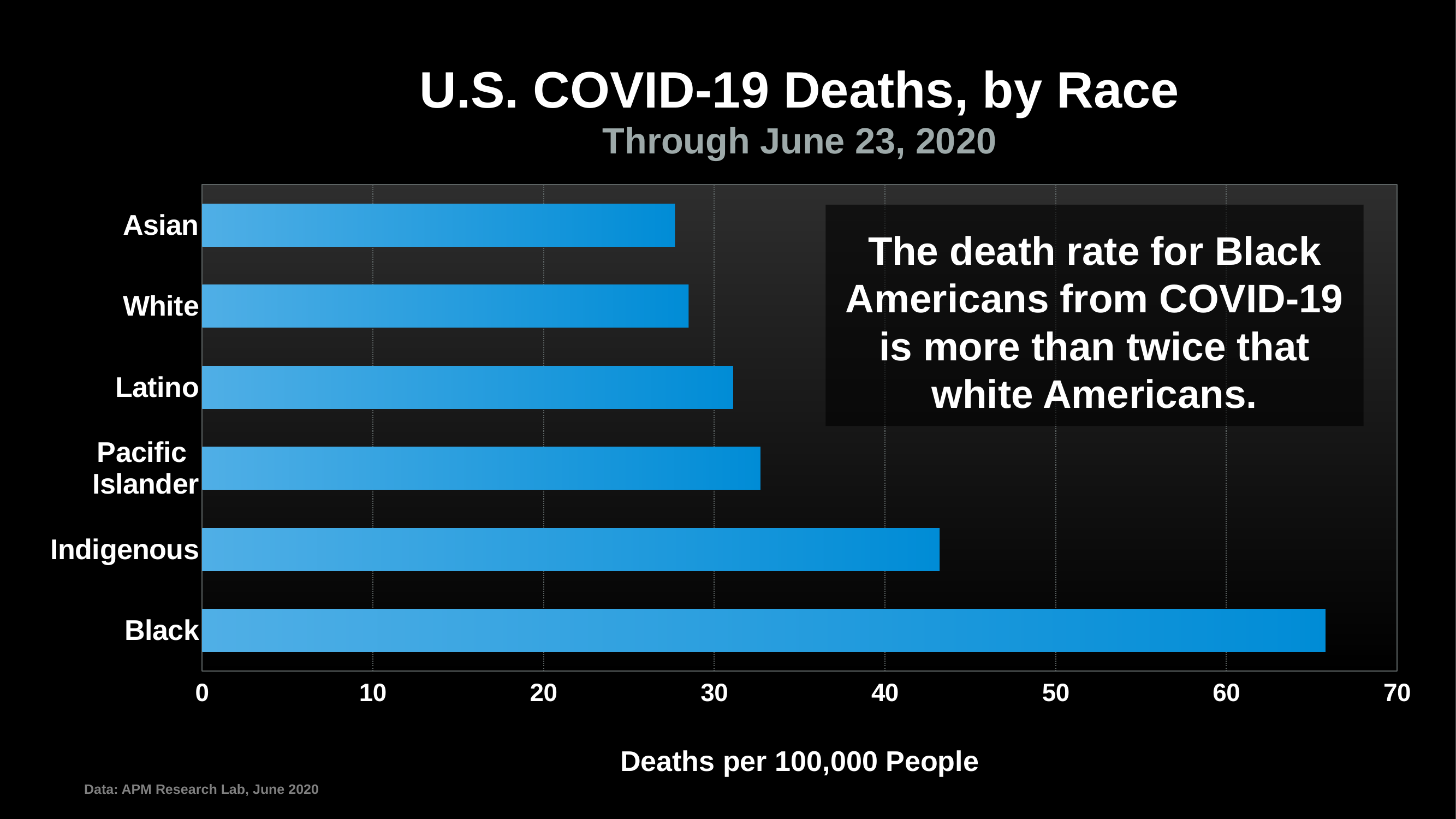
What is the label on the x axis of the chart? Deaths per 100,000 People Is the value for Black greater or less than 60? greater Is the value for Pacific Islander greater or less than 30? greater Is the value for Indigenous greater or less than 40? greater How many racial groups are plotted in the chart? 6 Which has a higher death rate, Black or Indigenous? Black Which has a higher death rate, Indigenous or Pacific Islander? Indigenous Which racial group has the highest COVID-19 death rate in the chart? Black What kind of chart is shown on the slide? bar chart What is the title of the chart? U.S. COVID-19 Deaths, by Race